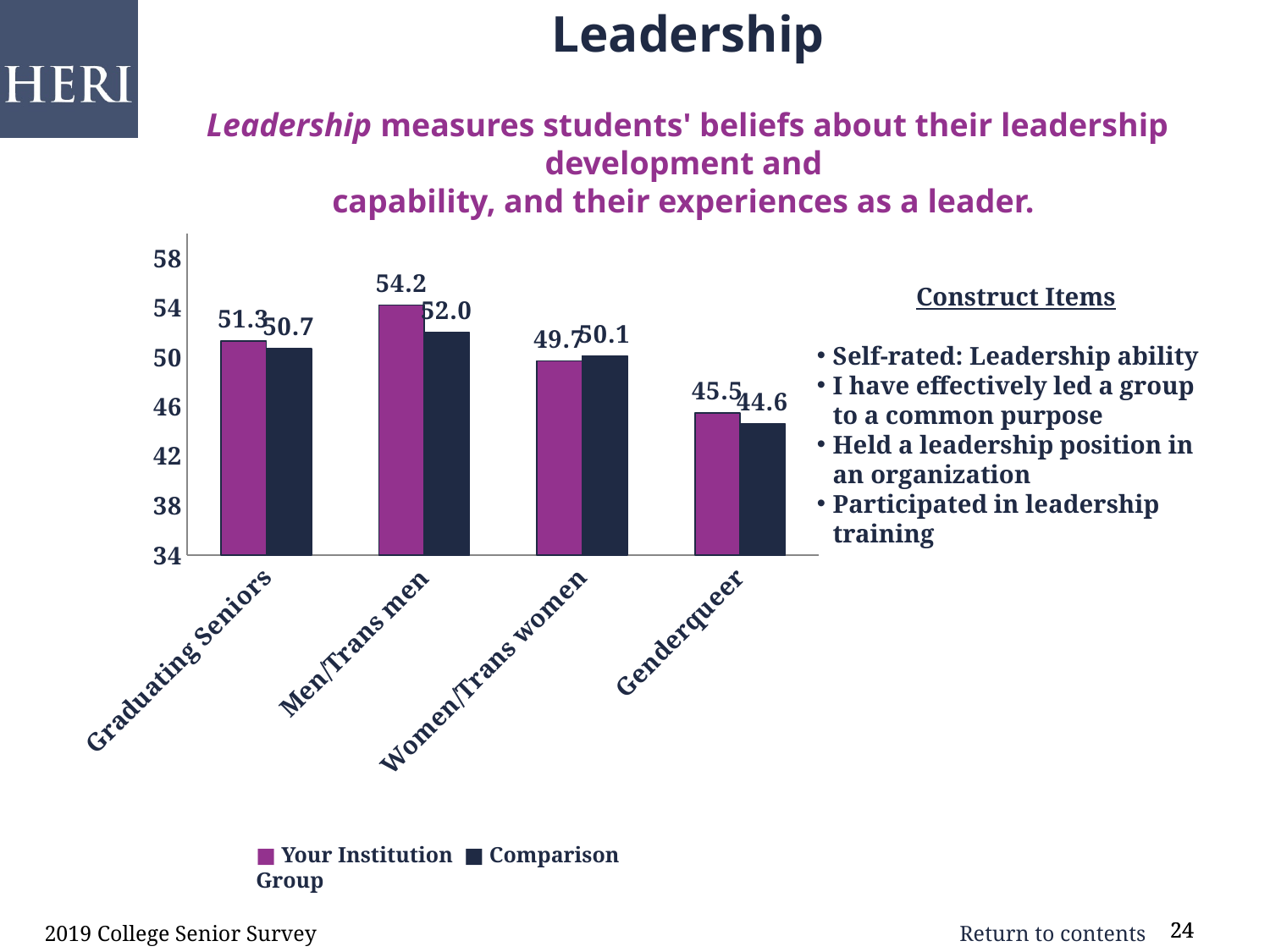
What is the Your Institution value for Men/Trans men? 54.2 What kind of chart is shown on the slide? Bar chart What is the difference between the Your Institution and Comparison Group values for Men/Trans men? 2.2 Is the Your Institution value for Genderqueer greater or less than 46? less Which category has the lowest Comparison Group value? Genderqueer What is the lowest value shown on the y axis? 34 How many series does the legend list? 2 For Women/Trans women, which is larger: the Your Institution value or the Comparison Group value? Comparison Group Which category has the highest Your Institution value? Men/Trans men What is the Comparison Group value for Genderqueer? 44.6 What is the Comparison Group value for Graduating Seniors? 50.7 How many categories are shown on the x axis? 4